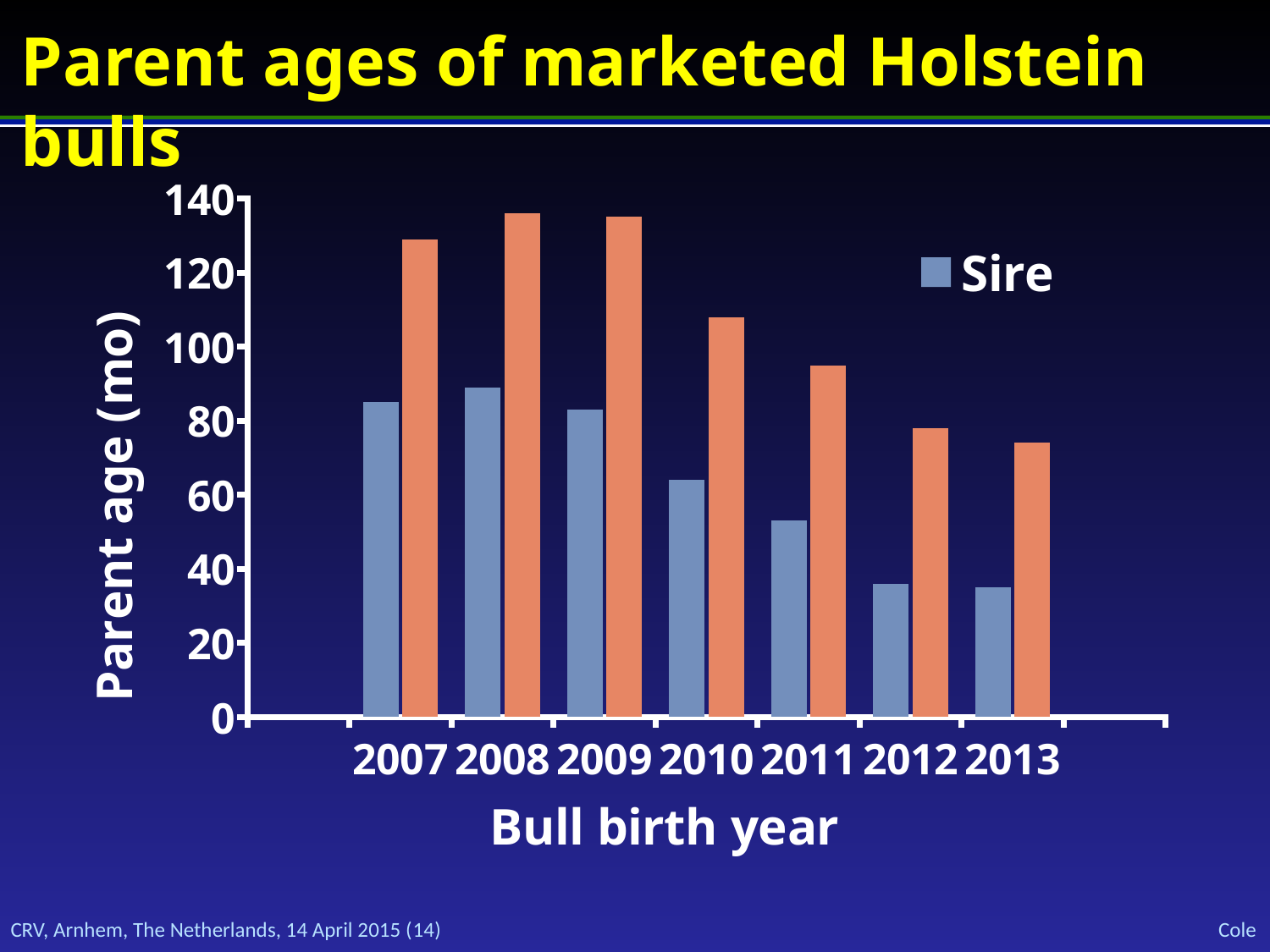
What kind of chart is shown on the slide? bar chart Do the Sire values generally rise or fall from 2007 to 2013? fall Is the Sire value for 2010 greater or less than 80? less Is the orange bar for 2011 greater or less than 100? less Which bull birth year has the highest Sire value? 2008 What is the title of the x axis? Bull birth year Is the orange bar for 2010 greater or less than 100? greater How many bull birth years are shown on the x axis? 7 Which is larger, the Sire value for 2007 or the Sire value for 2011? 2007 What is the title of the y axis? Parent age (mo)